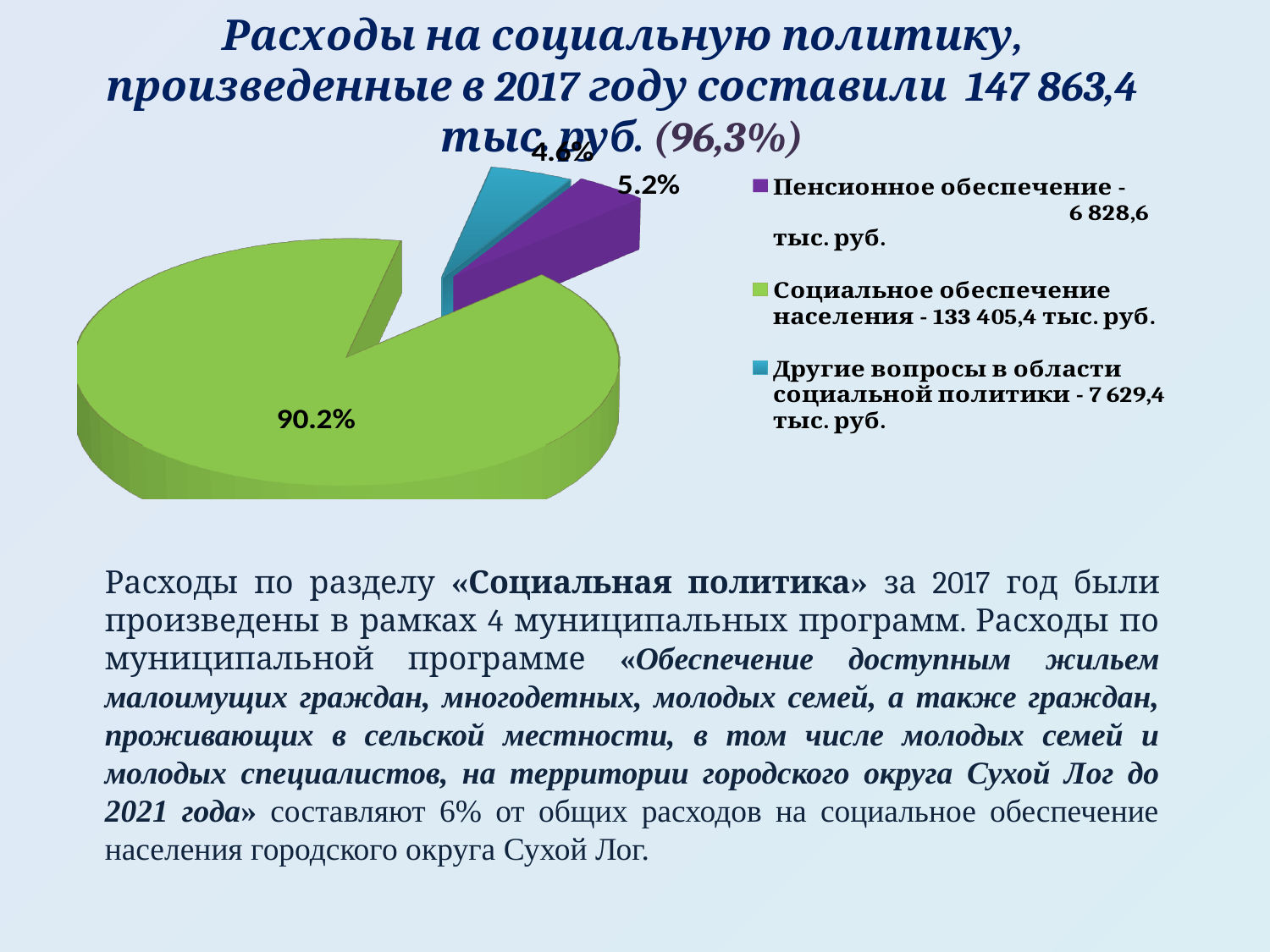
Which category has the largest slice of the pie? Социальное обеспечение населения How many slices does the pie chart have? 3 What is the difference between the values for Другие вопросы в области социальной политики and Пенсионное обеспечение? 800,8 тыс. руб. Which is larger: Другие вопросы в области социальной политики or Пенсионное обеспечение? Другие вопросы в области социальной политики What share of the pie does Социальное обеспечение населения take? 90.2% Which category has the smallest value in the legend? Пенсионное обеспечение What colour is the slice for Социальное обеспечение населения? green According to the slide title, what was the total spending on social policy in 2017? 147 863,4 тыс. руб. What kind of chart is shown on the slide? pie chart According to the legend, what is the value for Социальное обеспечение населения? 133 405,4 тыс. руб. According to the legend, what is the value for Пенсионное обеспечение? 6 828,6 тыс. руб. According to the legend, what is the value for Другие вопросы в области социальной политики? 7 629,4 тыс. руб.